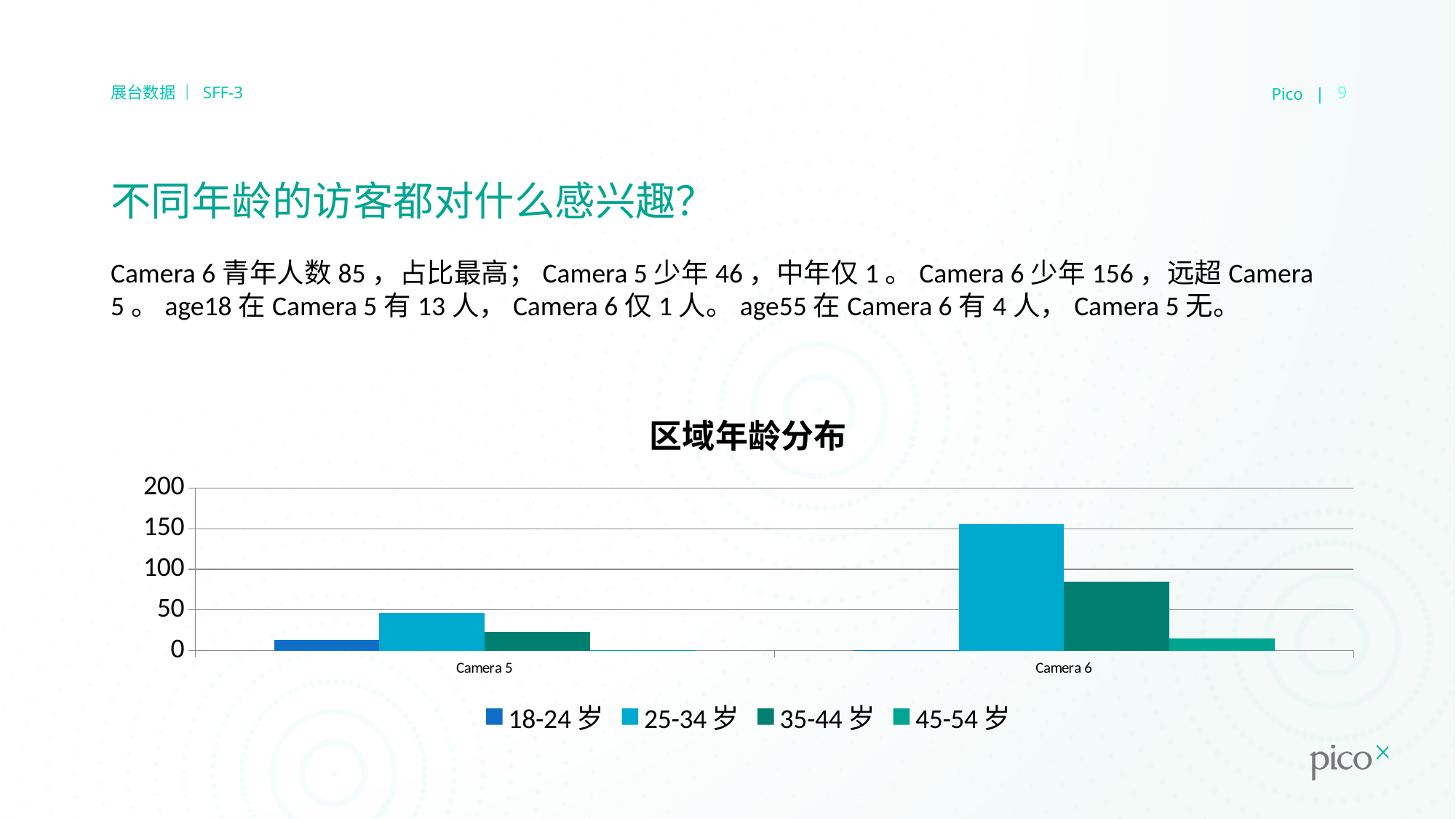
Which is larger, the 25-34 岁 value for Camera 5 or for Camera 6? Camera 6 How many categories are shown on the x axis of the 区域年龄分布 chart? 2 Is the value for 25-34 岁 at Camera 6 greater or less than 100? greater How many series does the legend of the 区域年龄分布 chart list? 4 Within Camera 5, which age series has the tallest bar? 25-34 岁 Is the value for 35-44 岁 at Camera 6 greater or less than 50? greater At Camera 5, which is larger, the 18-24 岁 bar or the 35-44 岁 bar? 35-44 岁 What kind of chart is shown under the title 区域年龄分布? bar chart What is the title of the chart on the slide? 区域年龄分布 Within Camera 6, which age series has the tallest bar? 25-34 岁 Which category contains the tallest bar in the 区域年龄分布 chart? Camera 6